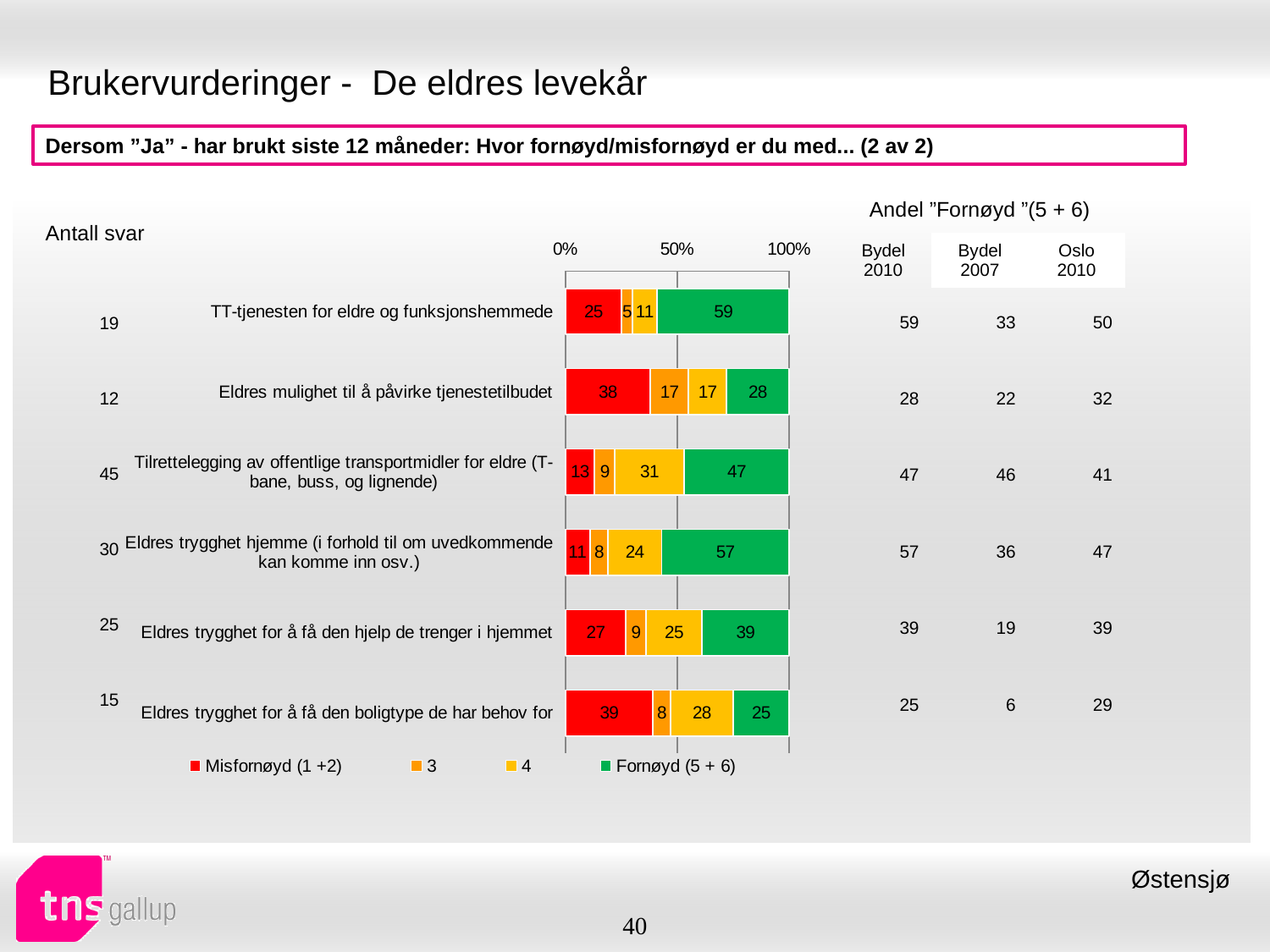
How many series does the legend of the bar chart list? 4 What is the Fornøyd (5 + 6) value for 'TT-tjenesten for eldre og funksjonshemmede'? 59 Which is larger: the Misfornøyd (1 +2) value for 'Eldres trygghet for å få den boligtype de har behov for' or for 'Eldres trygghet for å få den hjelp de trenger i hjemmet'? Eldres trygghet for å få den boligtype de har behov for Which category has the lowest Fornøyd (5 + 6) value? Eldres trygghet for å få den boligtype de har behov for What is the difference between the Fornøyd (5 + 6) values for 'Eldres trygghet hjemme (i forhold til om uvedkommende kan komme inn osv.)' and 'Eldres trygghet for å få den hjelp de trenger i hjemmet'? 18 What colour represents the Fornøyd (5 + 6) series in the bar chart? Green Which category has the highest Fornøyd (5 + 6) value? TT-tjenesten for eldre og funksjonshemmede What kind of chart is shown on the slide? Stacked bar chart What is the Misfornøyd (1 +2) value for 'Eldres mulighet til å påvirke tjenestetilbudet'? 38 How many categories (rows) does the bar chart show? 6 What is the value of series '4' for 'Tilrettelegging av offentlige transportmidler for eldre (T-bane, buss, og lignende)'? 31 What is the total of the stacked bar for 'Eldres mulighet til å påvirke tjenestetilbudet'? 100